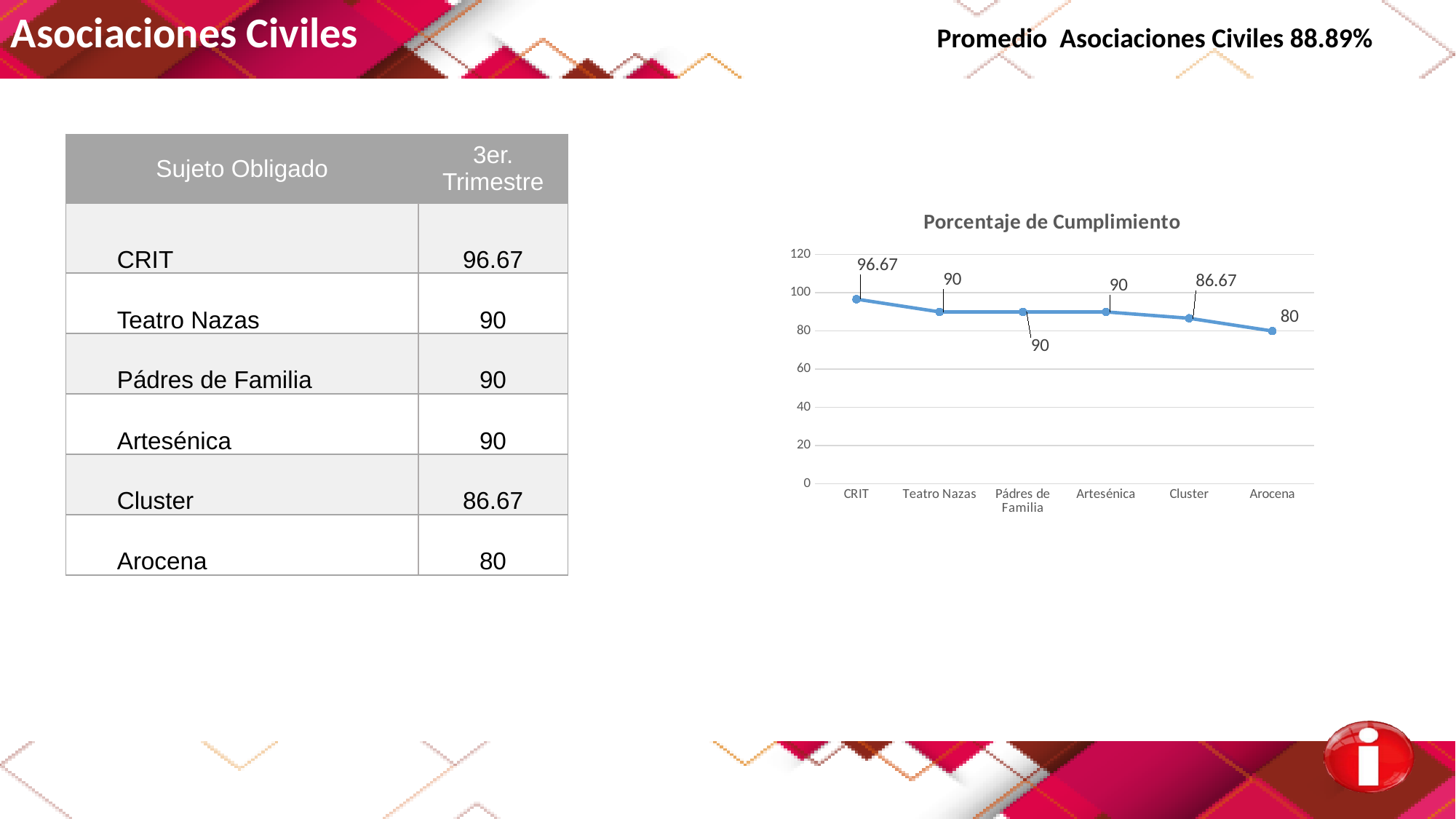
What is the value for Arocena in the Porcentaje de Cumplimiento chart? 80 What is the difference between the values for CRIT and Arocena in the Porcentaje de Cumplimiento chart? 16.67 Which category has the highest value in the Porcentaje de Cumplimiento chart? CRIT Is the value for Arocena in the Porcentaje de Cumplimiento chart greater or less than 100? less What is the value for Cluster in the Porcentaje de Cumplimiento chart? 86.67 What is the value for CRIT in the Porcentaje de Cumplimiento chart? 96.67 Do the values in the Porcentaje de Cumplimiento chart rise or fall from CRIT to Arocena? fall Which is larger in the Porcentaje de Cumplimiento chart, the value for Cluster or the value for Artesénica? Artesénica What kind of chart is the Porcentaje de Cumplimiento chart? line chart Which category has the lowest value in the Porcentaje de Cumplimiento chart? Arocena How many categories are plotted in the Porcentaje de Cumplimiento chart? 6 What is the value for Teatro Nazas in the Porcentaje de Cumplimiento chart? 90